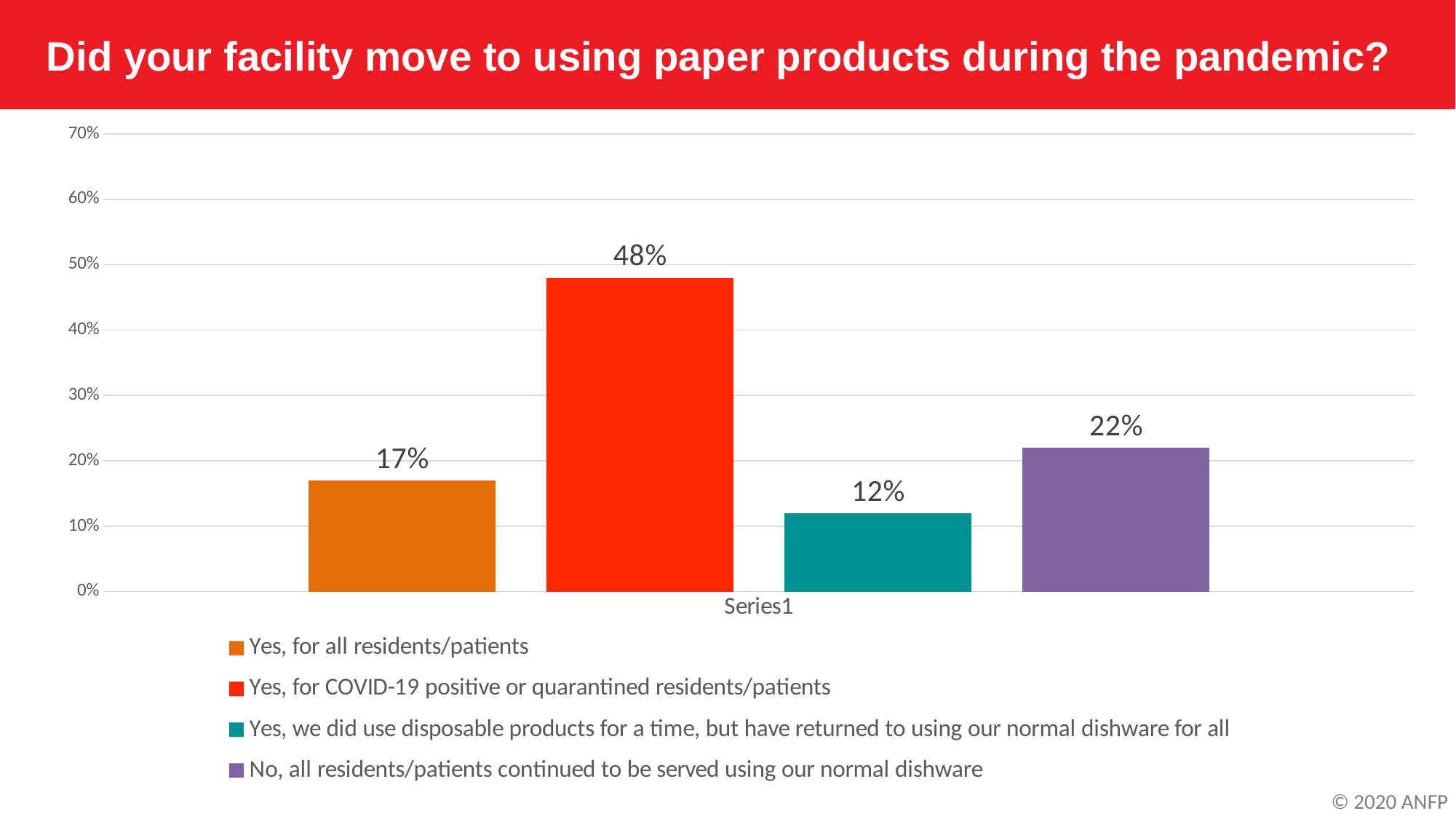
What type of chart is shown on the slide? Bar chart How many response options are shown in the legend? 4 What percentage of respondents said yes, for COVID-19 positive or quarantined residents/patients? 48% Is the value for 'Yes, for COVID-19 positive or quarantined residents/patients' greater or less than 40%? greater What percentage said they used disposable products for a time but have returned to normal dishware for all? 12% Which is larger: the percentage for 'Yes, for all residents/patients' or for 'No, all residents/patients continued to be served using our normal dishware'? No, all residents/patients continued to be served using our normal dishware Which response has the highest percentage? Yes, for COVID-19 positive or quarantined residents/patients What is the difference in percentage points between 'Yes, for COVID-19 positive or quarantined residents/patients' and 'No, all residents/patients continued to be served using our normal dishware'? 26 percentage points What percentage said no, all residents/patients continued to be served using normal dishware? 22% What colour is the bar for 'Yes, for COVID-19 positive or quarantined residents/patients'? Red What percentage of respondents said yes, for all residents/patients? 17% Which response has the lowest percentage? Yes, we did use disposable products for a time, but have returned to using our normal dishware for all